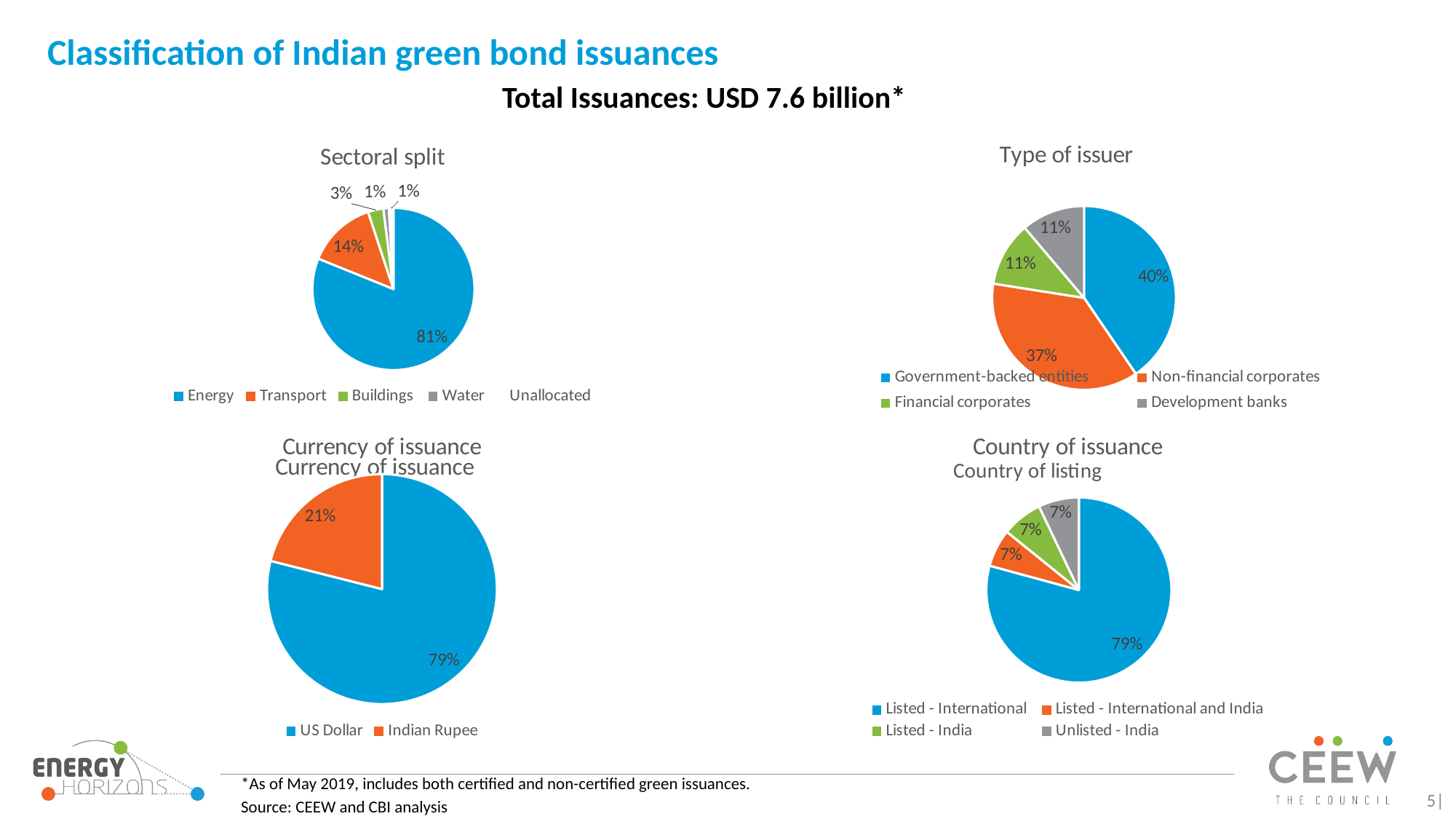
In the 'Currency of issuance' chart, what share does the Indian Rupee have? 21% In the 'Sectoral split' chart, what share does Transport have? 14% What type of chart is used for the 'Type of issuer' chart? Pie chart In the 'Sectoral split' chart, how many categories does the legend list? 5 In the 'Currency of issuance' chart, which currency has the larger share, US Dollar or Indian Rupee? US Dollar In the 'Country of listing' chart, what share does 'Listed - International' have? 79% In the 'Sectoral split' chart, what share does Energy have? 81% In the 'Type of issuer' chart, what share do Non-financial corporates have? 37% In the 'Type of issuer' chart, what share do Government-backed entities have? 40% In the 'Sectoral split' chart, which sector has the largest share? Energy In the 'Country of listing' chart, what share does 'Unlisted - India' have? 7% In the 'Type of issuer' chart, what is the difference between the shares of Government-backed entities and Non-financial corporates? 3%